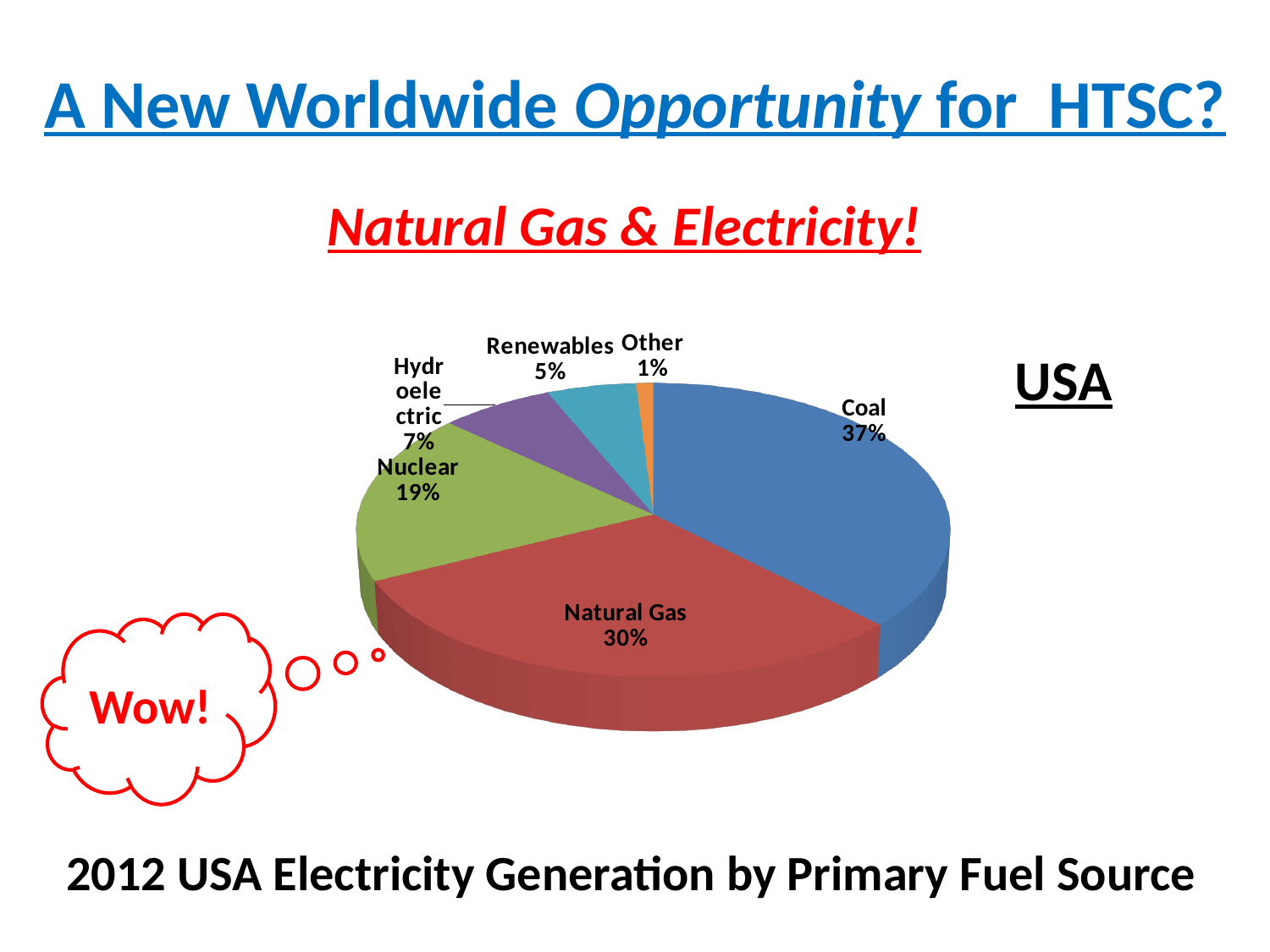
What share of the pie is labelled Natural Gas? 30% What percentage is shown for Hydroelectric? 7% Which is larger, the Nuclear slice or the Hydroelectric slice? Nuclear What share of 2012 USA electricity generation came from Coal? 37% What kind of chart is shown on the slide? Pie chart What is the caption below the chart? 2012 USA Electricity Generation by Primary Fuel Source What is the difference in percentage points between Coal and Natural Gas? 7 What percentage is shown for Renewables? 5% Which fuel source has the largest slice of the pie? Coal Which fuel source has the smallest slice of the pie? Other How many fuel source categories are shown in the pie chart? 6 What percentage is shown for Nuclear? 19%